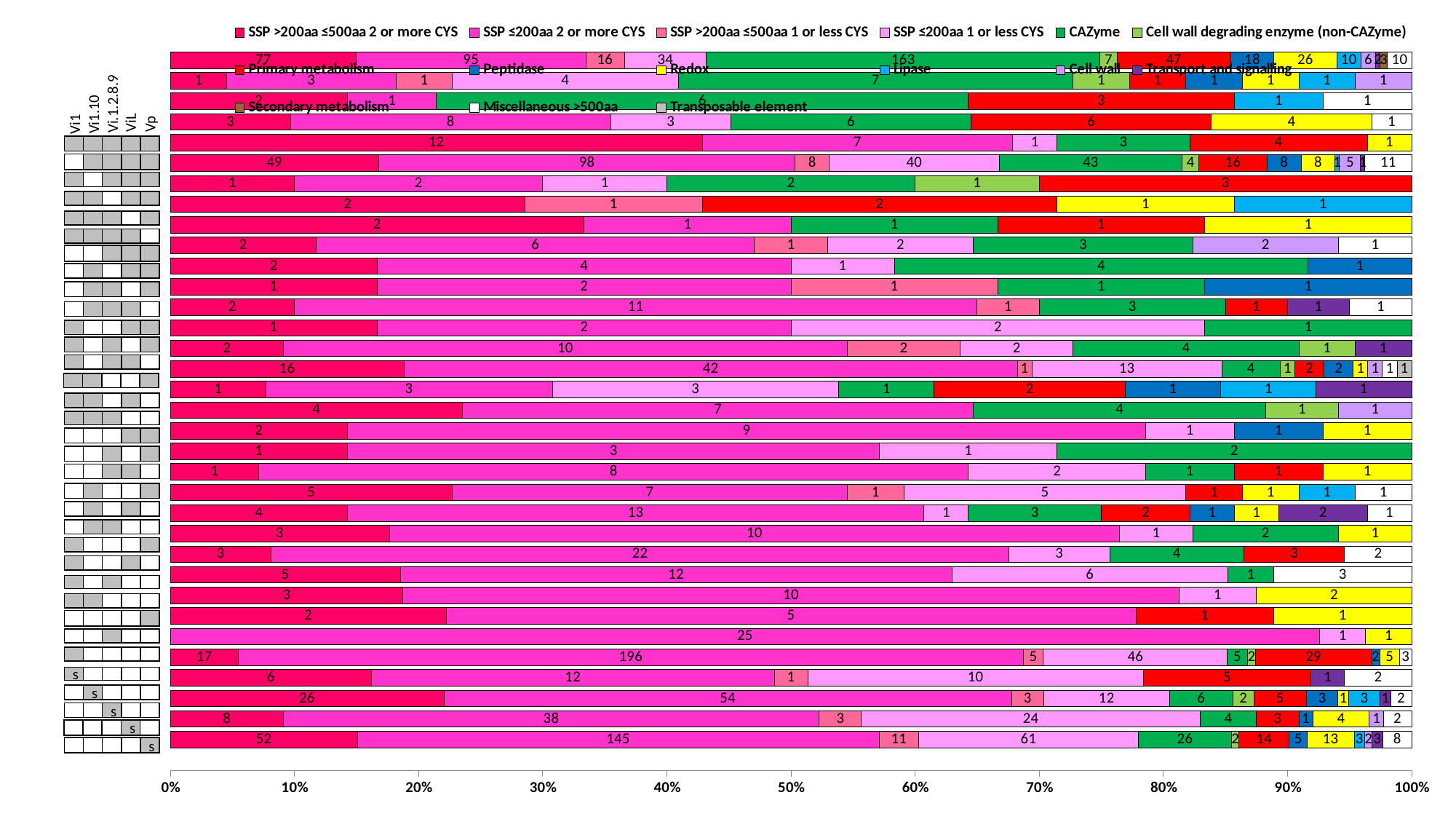
In the top bar, which is larger: the SSP >200aa ≤500aa 2 or more CYS segment or the SSP ≤200aa 2 or more CYS segment? SSP ≤200aa 2 or more CYS In the top bar, what is the value of the SSP >200aa ≤500aa 2 or more CYS segment? 77 What colour represents CAZyme in the legend? green In the bottom bar, what is the value of the SSP ≤200aa 2 or more CYS segment? 145 In the top bar, which series has the largest segment? CAZyme How many series does the legend list? 15 In the bottom bar, what is the value of the SSP >200aa ≤500aa 2 or more CYS segment? 52 In the top bar, what is the difference between the CAZyme segment and the SSP ≤200aa 2 or more CYS segment? 68 What is the maximum value shown on the x axis? 100% In the bottom bar, what is the value of the CAZyme segment? 26 In the top bar, what is the value of the CAZyme segment? 163 What kind of chart is shown on the slide? bar chart